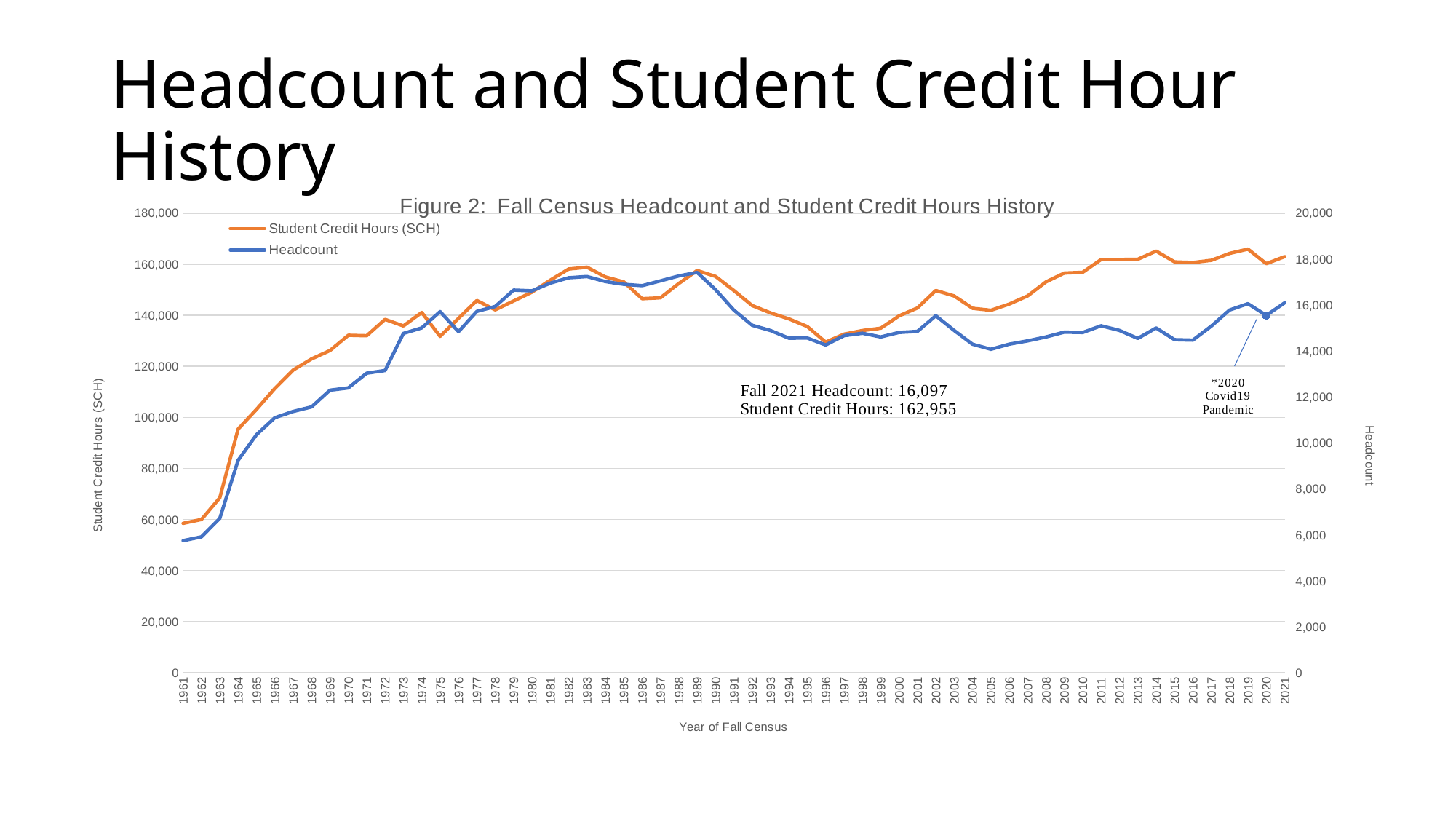
How many series does the legend list? 2 How many years are plotted along the x axis? 61 Is the Student Credit Hours value for 2014 greater or less than 160,000? greater What is the title of the chart? Figure 2: Fall Census Headcount and Student Credit Hours History What is the Fall 2021 Headcount according to the annotation on the chart? 16,097 Is the Headcount value larger in 1989 or in 2005? 1989 What kind of chart is shown on the slide? line chart What is the Fall 2021 Student Credit Hours value according to the annotation on the chart? 162,955 Is the Headcount value for 1996 greater or less than 16,000? less Which year has the lowest Student Credit Hours value? 1961 Is the Student Credit Hours value for 1961 greater or less than 80,000? less Does the Student Credit Hours line rise or fall from 1961 to 1983? rise